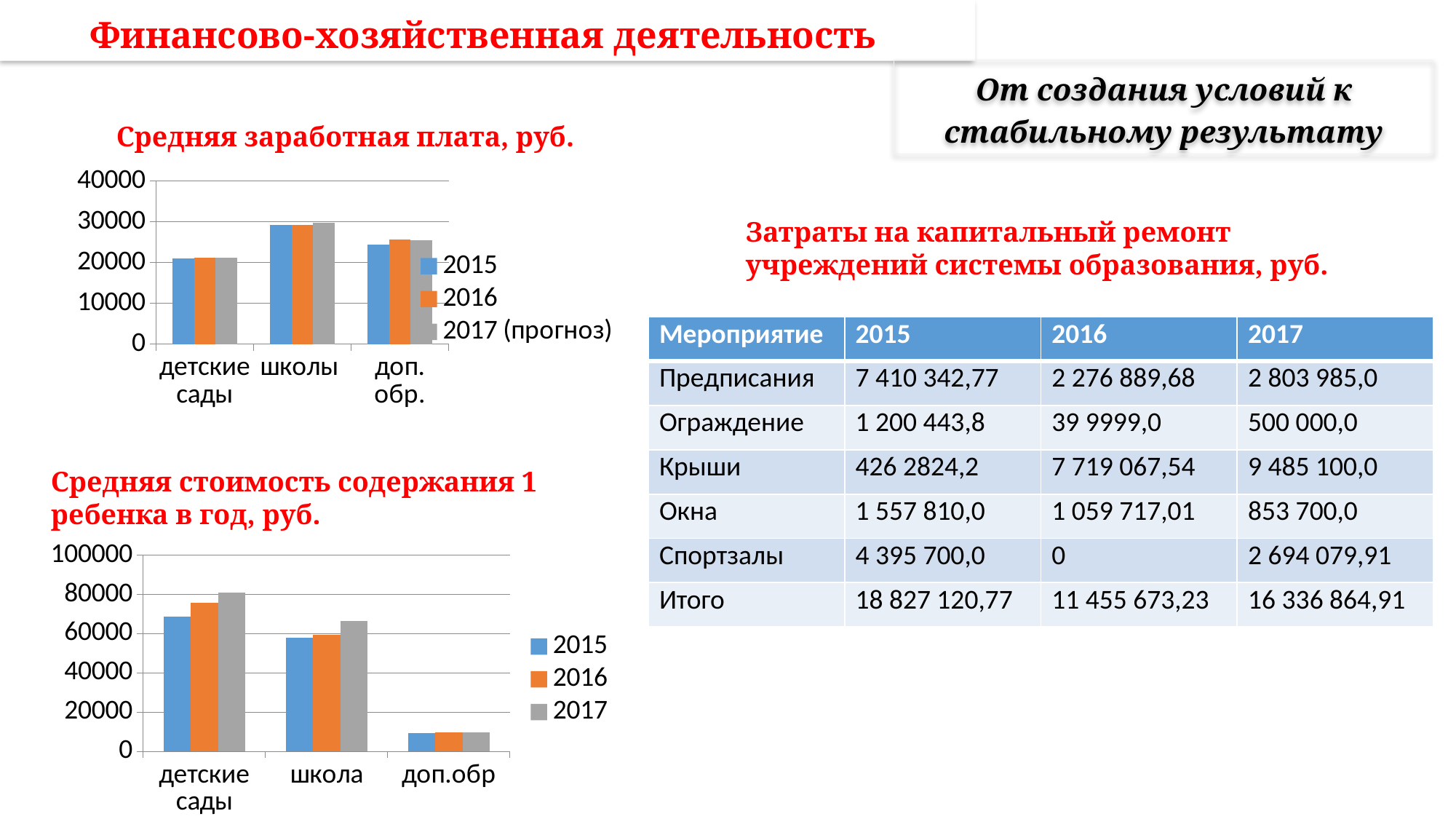
In the 'Средняя заработная плата, руб.' chart, what is the label of the third legend entry? 2017 (прогноз) In the 'Средняя стоимость содержания 1 ребенка в год, руб.' chart, is the 2015 value for доп.обр greater or less than 20000? less In the 'Средняя заработная плата, руб.' chart, which is larger for 2016: школы or детские сады? школы In the 'Средняя стоимость содержания 1 ребенка в год, руб.' chart, which is larger for 2015: детские сады or школа? детские сады How many categories are shown on the x axis of the 'Средняя заработная плата, руб.' chart? 3 How many series does the legend of the 'Средняя заработная плата, руб.' chart list? 3 In the 'Средняя заработная плата, руб.' chart, which category has the highest value for 2015? школы In the 'Средняя заработная плата, руб.' chart, is the 2015 value for детские сады greater or less than 30000? less How many series does the legend of the 'Средняя стоимость содержания 1 ребенка в год, руб.' chart list? 3 In the 'Средняя стоимость содержания 1 ребенка в год, руб.' chart, do the values for детские сады rise or fall from 2015 to 2017? rise In the 'Средняя стоимость содержания 1 ребенка в год, руб.' chart, which category has the lowest value for 2017? доп.обр What kind of chart is the 'Средняя заработная плата, руб.' chart? bar chart